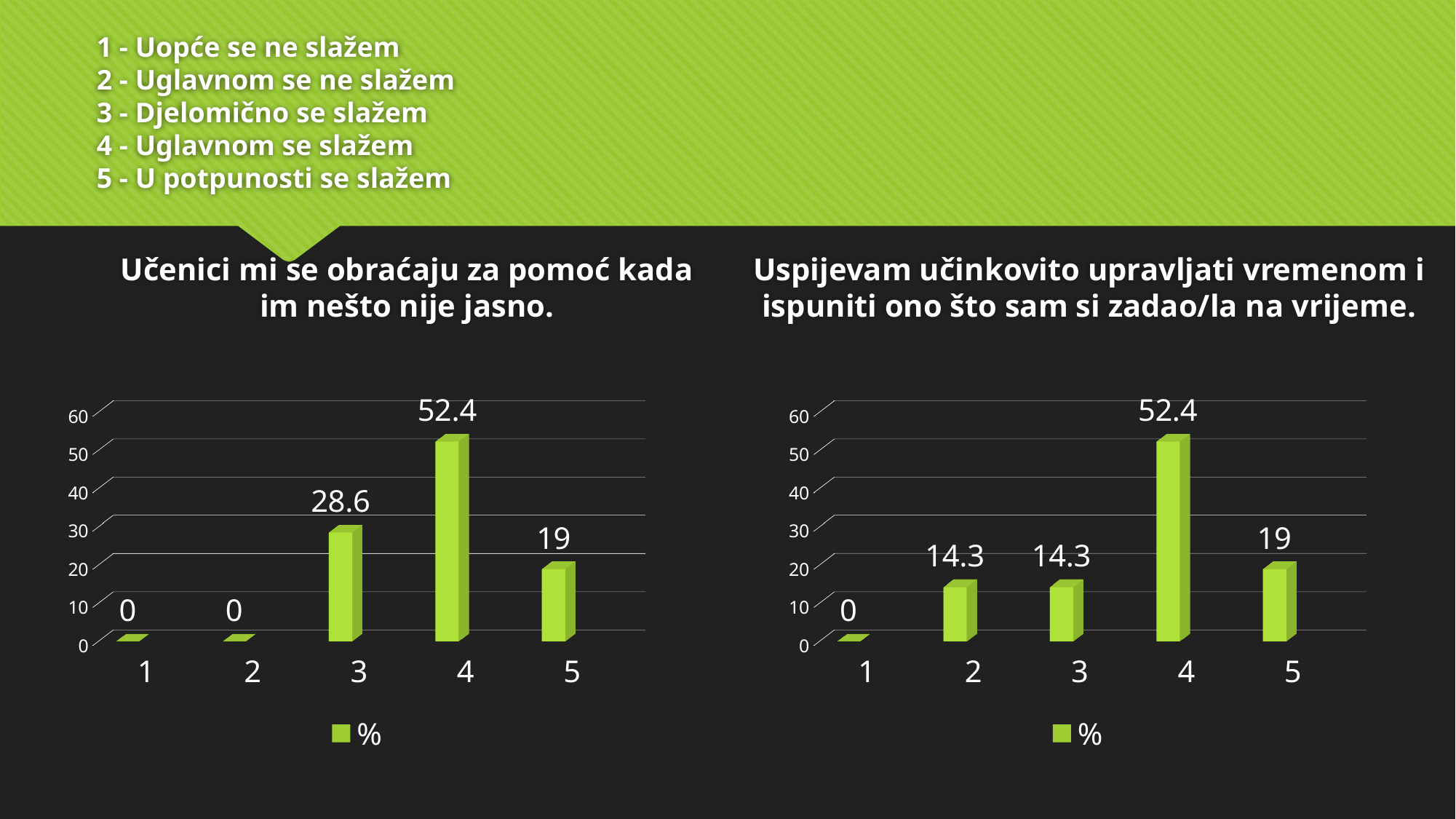
How many series does the legend of the right chart ('Uspijevam učinkovito upravljati vremenom...') list? 1 In the left chart ('Učenici mi se obraćaju za pomoć kada im nešto nije jasno.'), what is the difference between the values for category 4 and category 3? 23.8 In the right chart ('Uspijevam učinkovito upravljati vremenom...'), what is the value for category 1? 0 In the right chart ('Uspijevam učinkovito upravljati vremenom...'), which category has the lowest value? 1 In the right chart ('Uspijevam učinkovito upravljati vremenom...'), which is larger: the value for category 3 or the value for category 5? 5 In the right chart ('Uspijevam učinkovito upravljati vremenom...'), what is the difference between the values for category 4 and category 5? 33.4 In the left chart ('Učenici mi se obraćaju za pomoć kada im nešto nije jasno.'), which category has the highest value? 4 In the left chart ('Učenici mi se obraćaju za pomoć kada im nešto nije jasno.'), what is the value for category 5? 19 In the left chart ('Učenici mi se obraćaju za pomoć kada im nešto nije jasno.'), what is the value for category 3? 28.6 How many categories are shown on the x axis of the left chart ('Učenici mi se obraćaju za pomoć kada im nešto nije jasno.')? 5 What kind of chart is the left chart ('Učenici mi se obraćaju za pomoć kada im nešto nije jasno.')? bar chart In the right chart ('Uspijevam učinkovito upravljati vremenom...'), what is the value for category 2? 14.3